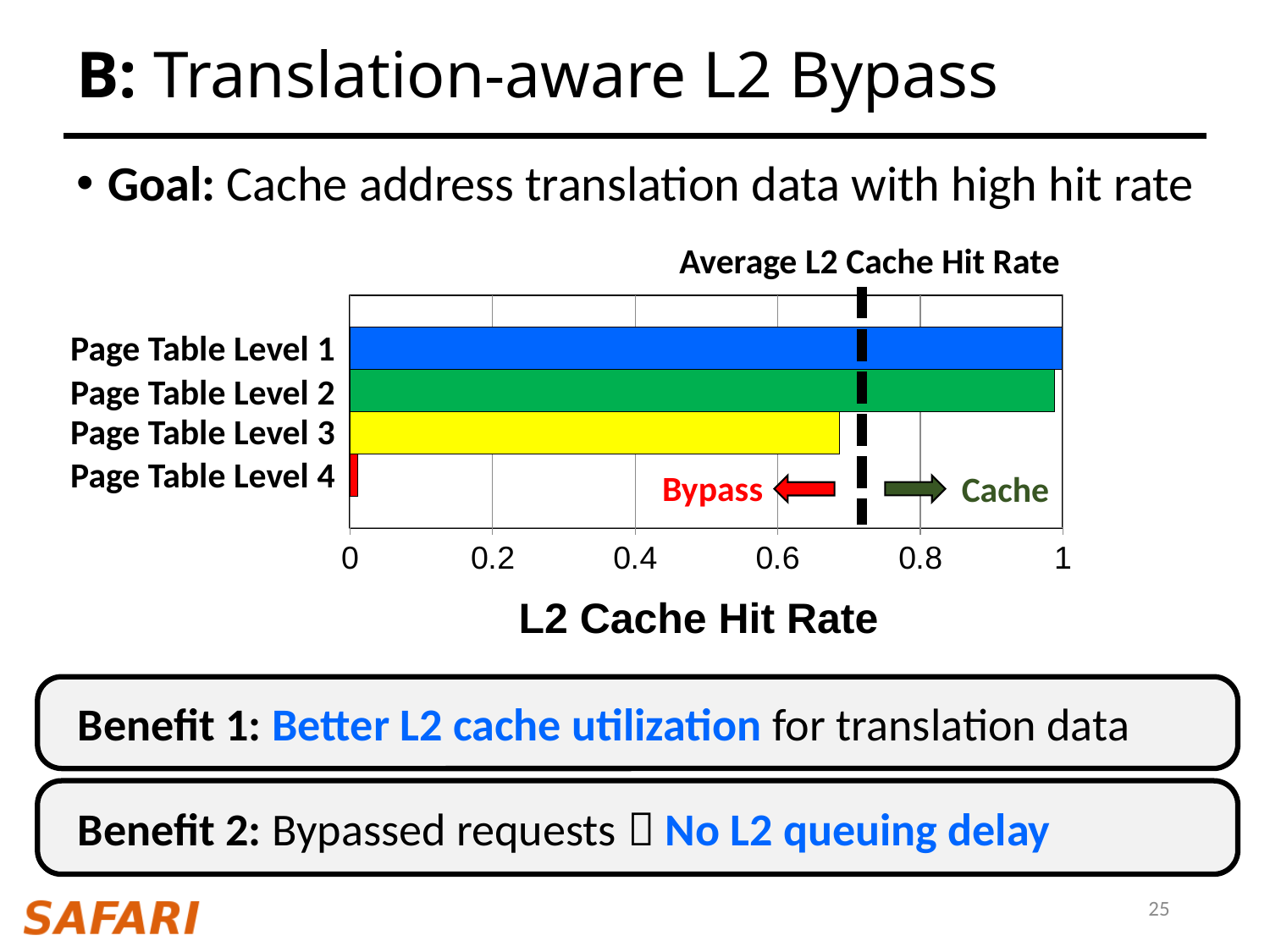
Is the L2 cache hit rate for Page Table Level 2 greater or less than 0.8? greater Which has a higher L2 cache hit rate, Page Table Level 3 or Page Table Level 4? Page Table Level 3 What kind of chart is shown on the slide? bar chart Do the L2 cache hit rates rise or fall going from Page Table Level 1 to Page Table Level 4? fall What is the title of the horizontal axis of the chart? L2 Cache Hit Rate Which page table level has the lowest L2 cache hit rate? Page Table Level 4 Is the L2 cache hit rate for Page Table Level 4 greater or less than 0.2? less Is the L2 cache hit rate for Page Table Level 3 greater or less than 0.8? less Which has a higher L2 cache hit rate, Page Table Level 1 or Page Table Level 3? Page Table Level 1 What does the dashed vertical line in the chart represent? Average L2 Cache Hit Rate How many page table levels are plotted in the chart? 4